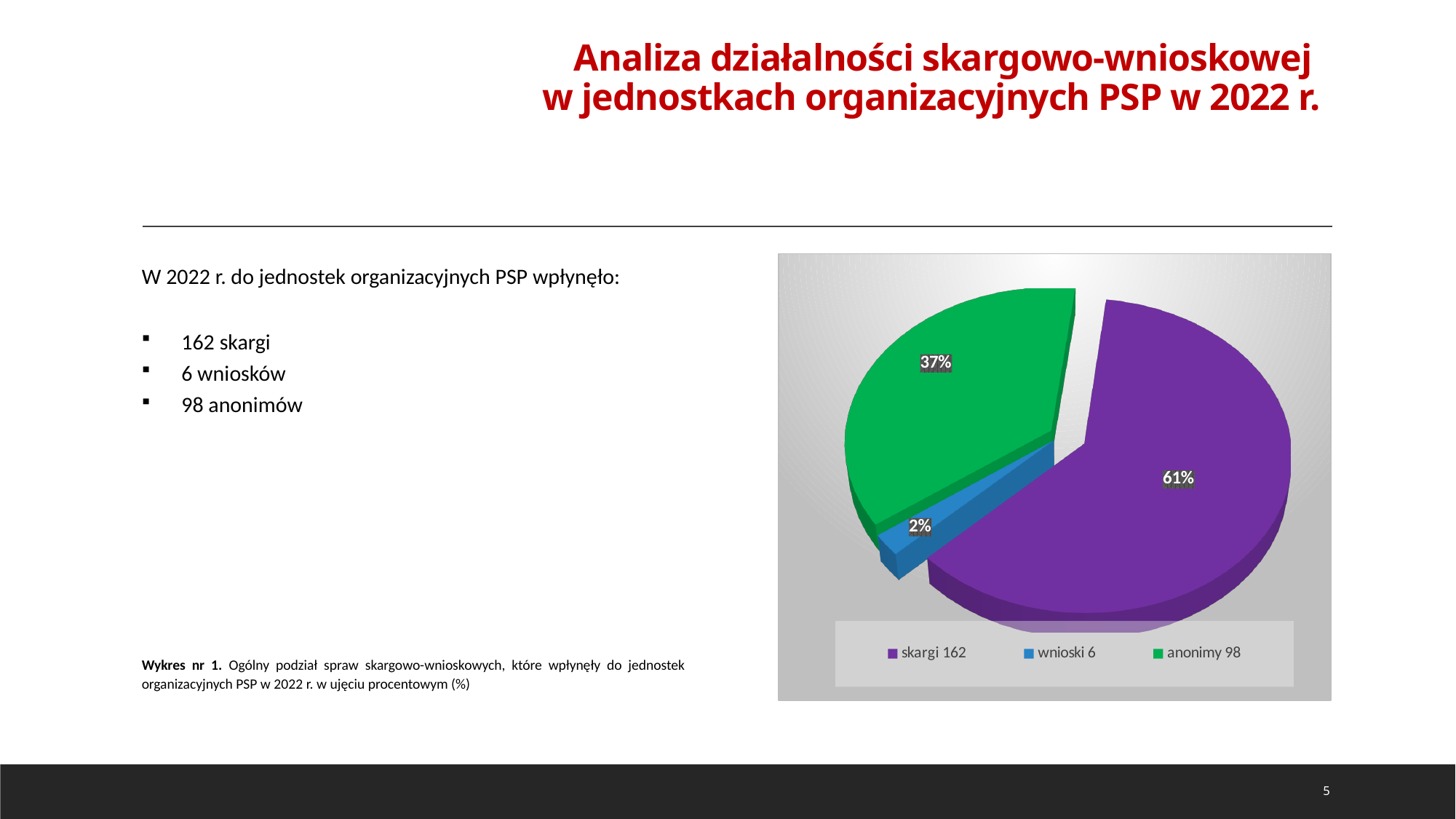
Which category has the smallest slice of the pie? wnioski How many entries does the legend list? 3 What count is shown next to 'anonimy' in the legend? 98 What colour is the skargi slice? purple What kind of chart is shown on the slide? pie chart Which category has the largest slice of the pie? skargi What percentage share does the skargi slice have? 61% What percentage share does the anonimy slice have? 37% What is the difference in percentage points between the skargi slice and the anonimy slice? 24 How many slices does the pie chart have? 3 Which slice is larger, anonimy or wnioski? anonimy What percentage share does the wnioski slice have? 2%